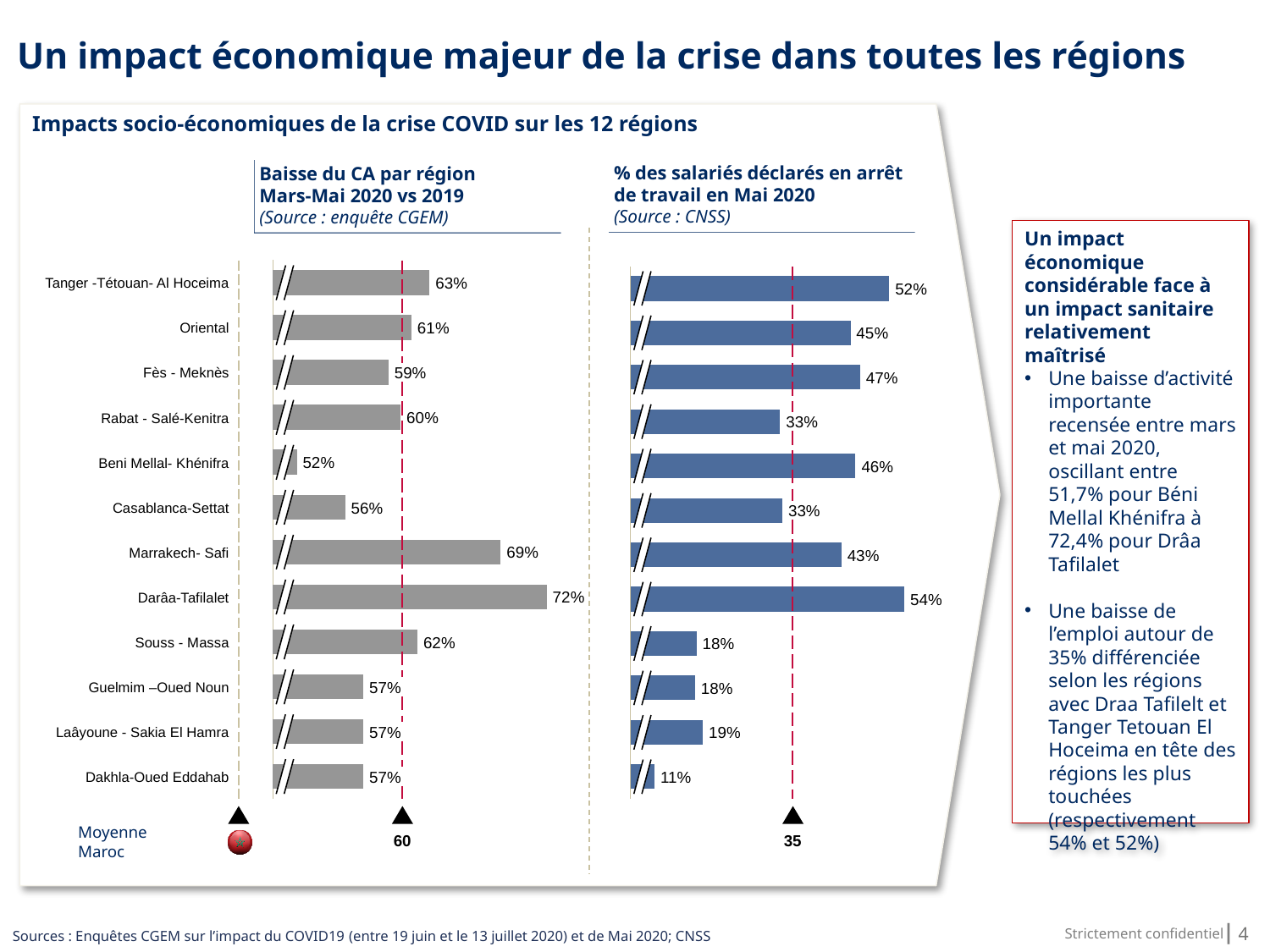
In the chart '% des salariés déclarés en arrêt de travail en Mai 2020', what is the difference between Tanger -Tétouan- Al Hoceima and Souss - Massa? 34% In the chart '% des salariés déclarés en arrêt de travail en Mai 2020', which region has the lowest value? Dakhla-Oued Eddahab What kind of chart is 'Baisse du CA par région Mars-Mai 2020 vs 2019'? Bar chart In the chart 'Baisse du CA par région Mars-Mai 2020 vs 2019', what is the difference between Marrakech- Safi and Casablanca-Settat? 13% In the chart '% des salariés déclarés en arrêt de travail en Mai 2020', what is the value for Rabat - Salé-Kenitra? 33% In the chart '% des salariés déclarés en arrêt de travail en Mai 2020', which region has the highest value? Darâa-Tafilalet In the chart 'Baisse du CA par région Mars-Mai 2020 vs 2019', what is the value for Darâa-Tafilalet? 72% How many regions are shown in the chart 'Baisse du CA par région Mars-Mai 2020 vs 2019'? 12 In the chart '% des salariés déclarés en arrêt de travail en Mai 2020', which is larger: Oriental or Fès - Meknès? Fès - Meknès What source is cited for the chart 'Baisse du CA par région Mars-Mai 2020 vs 2019'? enquête CGEM What is the 'Moyenne Maroc' value shown under the chart '% des salariés déclarés en arrêt de travail en Mai 2020'? 35 In the chart 'Baisse du CA par région Mars-Mai 2020 vs 2019', which region has the lowest value? Beni Mellal- Khénifra